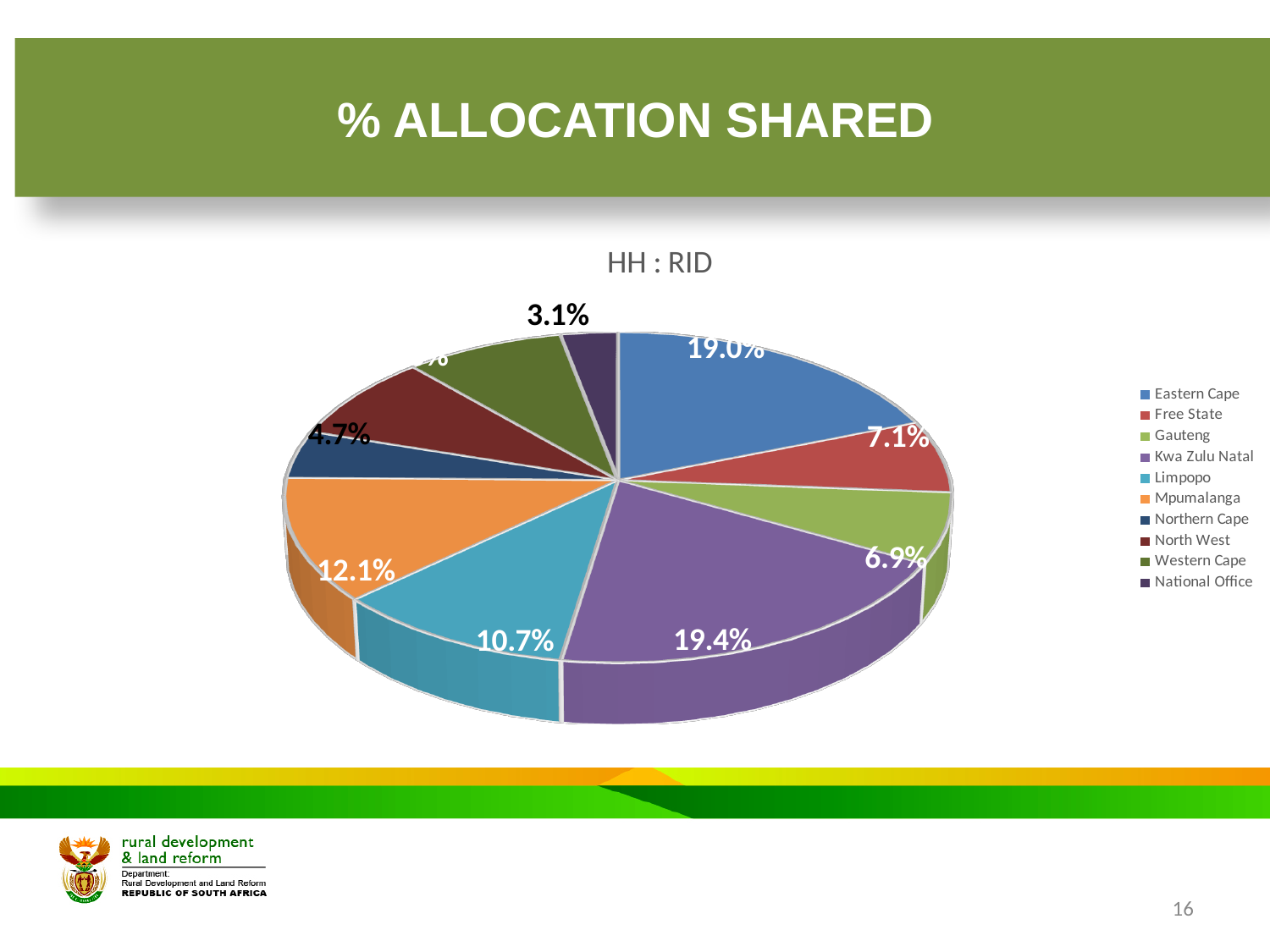
What is the title of the chart? HH : RID Which is larger, the share for Limpopo or the share for Mpumalanga? Mpumalanga Which category has the largest share of the pie? Kwa Zulu Natal What percentage is shown for Kwa Zulu Natal? 19.4% What percentage is shown for National Office? 3.1% How many categories does the legend list? 10 What percentage is shown for Mpumalanga? 12.1% What percentage is shown for Northern Cape? 4.7% Which category has the smallest share of the pie? National Office What percentage is shown for Eastern Cape? 19.0% What is the difference in percentage points between Kwa Zulu Natal and Eastern Cape? 0.4 What kind of chart is shown on the slide? Pie chart